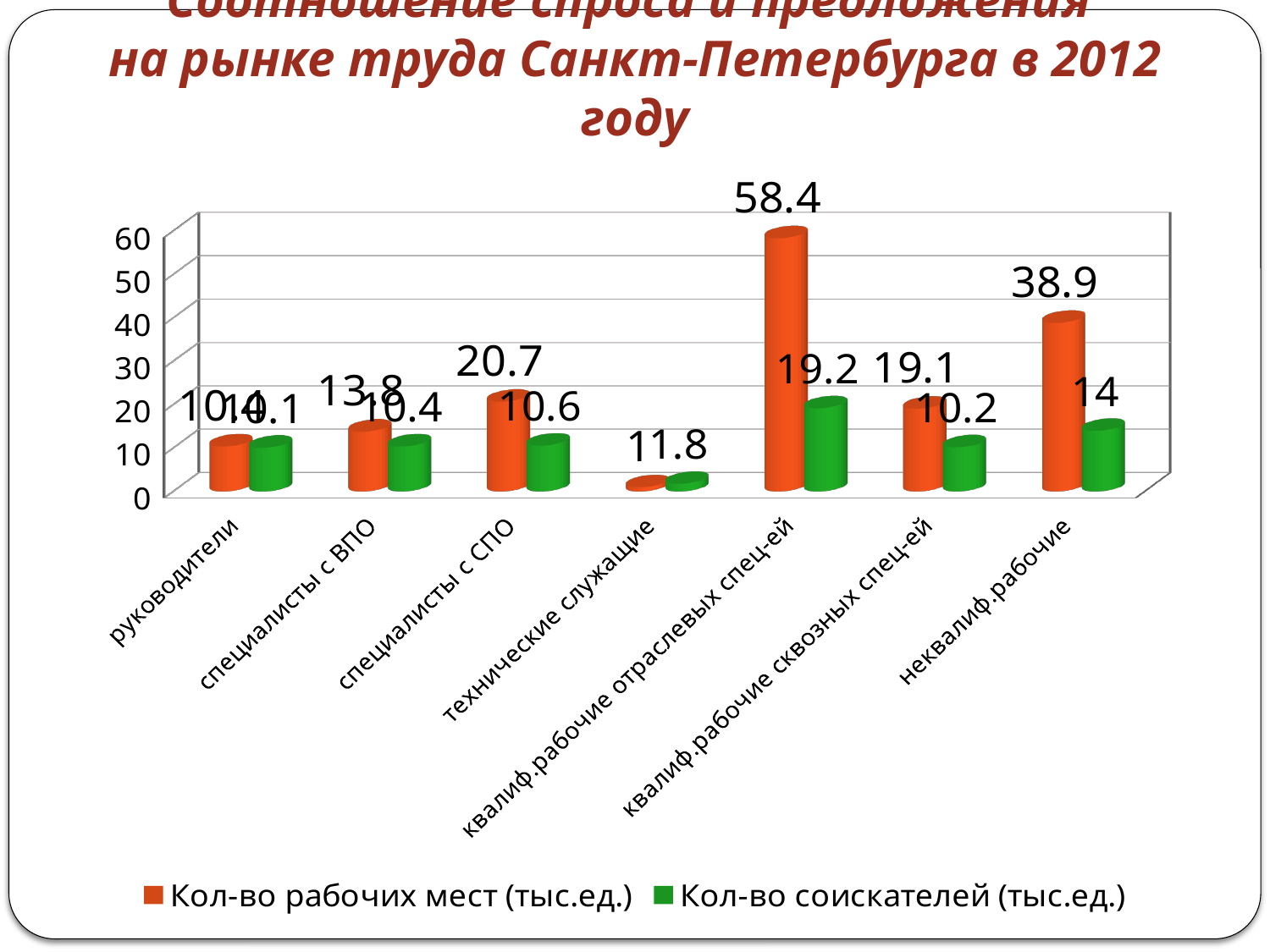
What is the value of Кол-во соискателей (тыс.ед.) for специалисты с ВПО? 10.4 Which category has the highest value for Кол-во рабочих мест (тыс.ед.)? квалиф.рабочие отраслевых спец-ей What is the value of Кол-во рабочих мест (тыс.ед.) for специалисты с СПО? 20.7 What is the difference between Кол-во рабочих мест (тыс.ед.) and Кол-во соискателей (тыс.ед.) for неквалиф.рабочие? 24.9 What is the value of Кол-во соискателей (тыс.ед.) for неквалиф.рабочие? 14 Is the value of Кол-во рабочих мест (тыс.ед.) for неквалиф.рабочие greater or less than 30? greater What is the value of Кол-во рабочих мест (тыс.ед.) for квалиф.рабочие отраслевых спец-ей? 58.4 Which category has the lowest value for Кол-во соискателей (тыс.ед.)? технические служащие What kind of chart is shown on the slide? bar chart For квалиф.рабочие сквозных спец-ей, which is larger: Кол-во рабочих мест (тыс.ед.) or Кол-во соискателей (тыс.ед.)? Кол-во рабочих мест (тыс.ед.) How many series does the legend list? 2 How many categories are shown on the x axis? 7